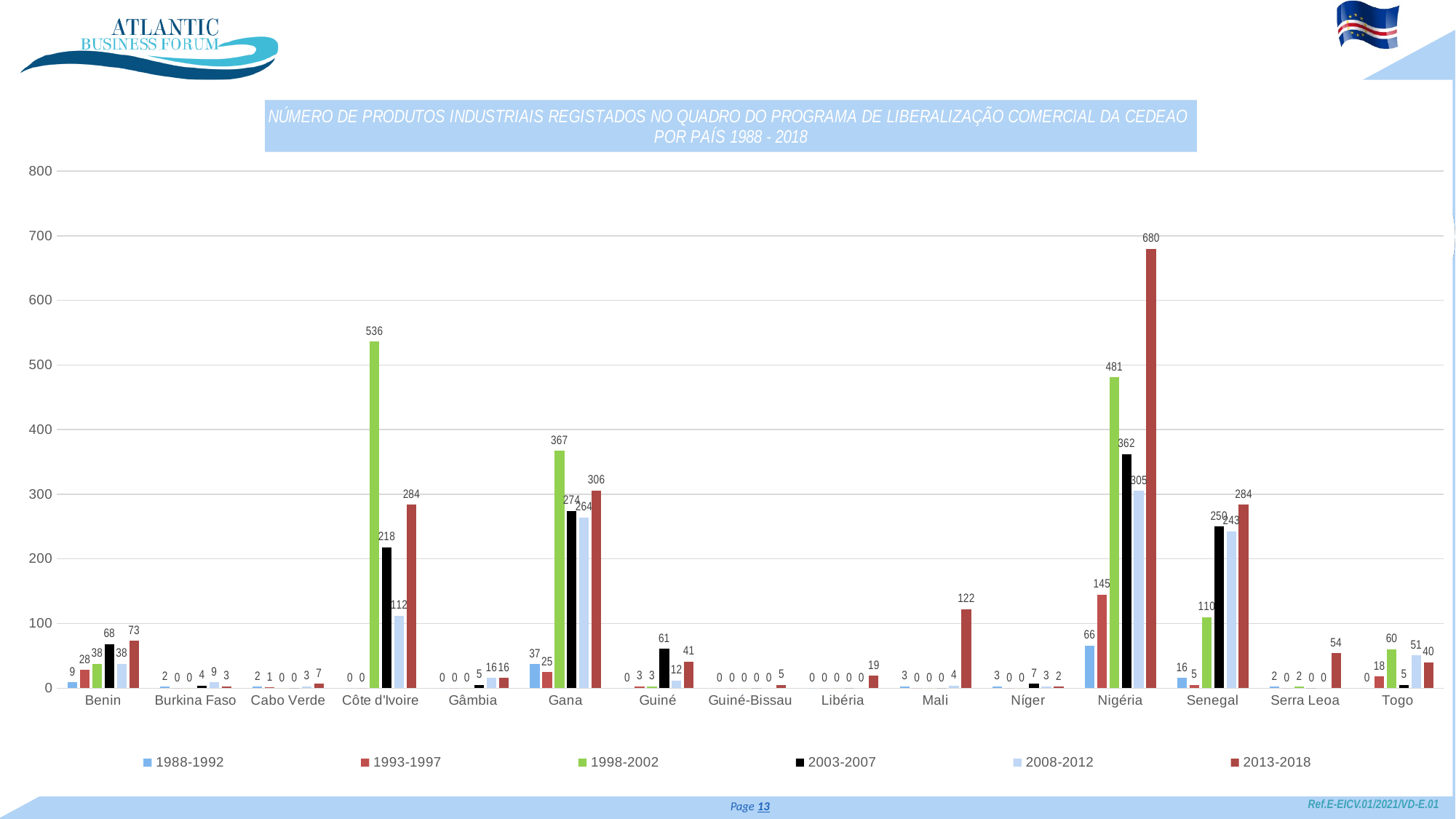
What is the value for Côte d'Ivoire in the 1998-2002 series? 536 Is the 1998-2002 value for Nigéria greater or less than 400? greater How many series does the legend list? 6 What is the value for Nigéria in the 2013-2018 series? 680 What is the value for Mali in the 2013-2018 series? 122 What kind of chart is shown on the slide? Bar chart How many countries are shown on the x axis? 15 What is the value for Senegal in the 2003-2007 series? 250 What is the difference between the 2013-2018 value for Nigéria and the 2013-2018 value for Gana? 374 Which country has the highest value in the 1998-2002 series? Côte d'Ivoire Which country has the highest value in the 2013-2018 series? Nigéria Which is larger: the 2003-2007 value for Gana or the 2003-2007 value for Senegal? Gana